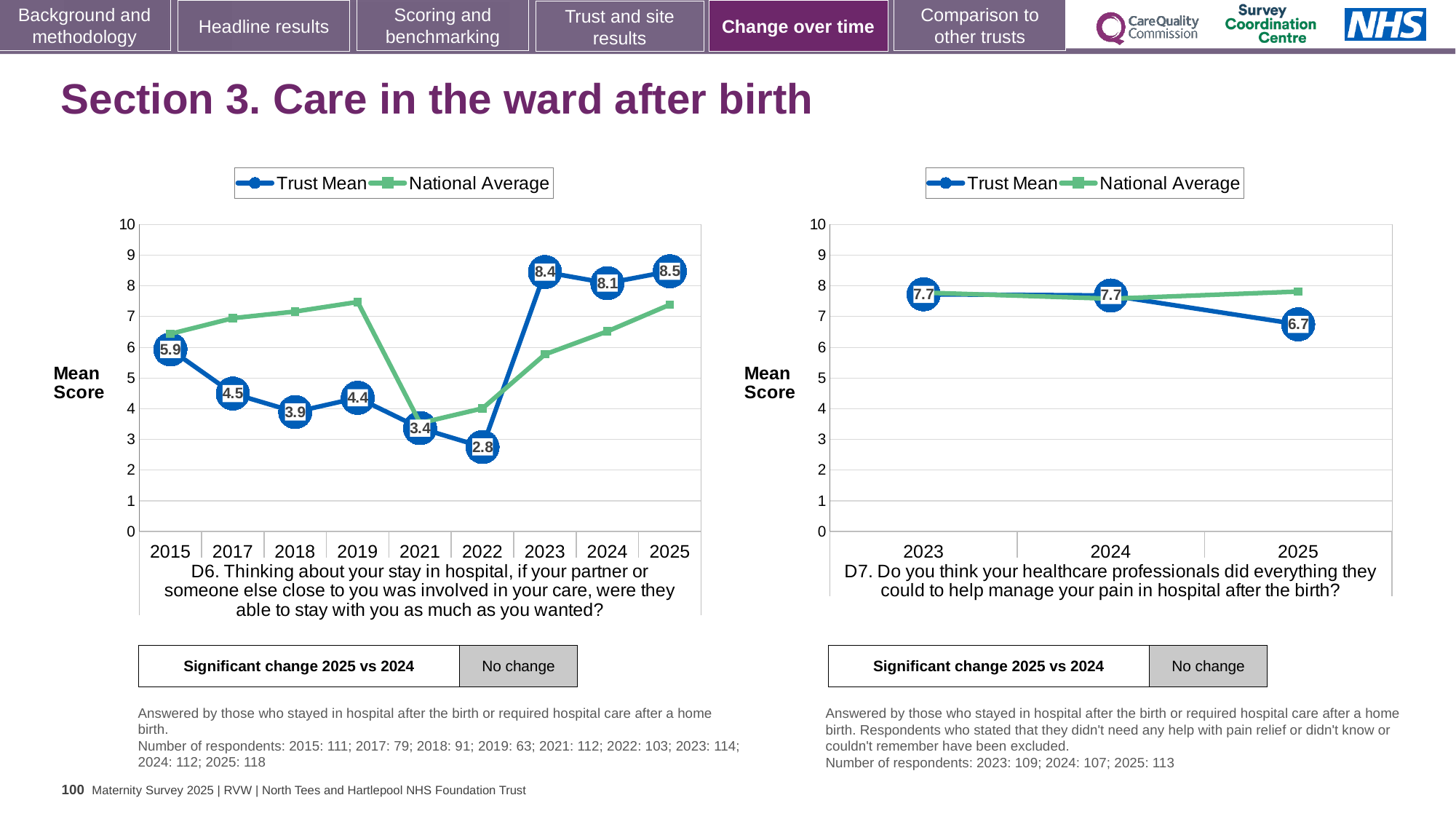
On the D6 chart (left), is the National Average for 2019 greater or less than 7? greater On the D6 chart (left), how many years are shown on the x axis? 9 On the D6 chart (left), what is the Trust Mean score for 2022? 2.8 On the D7 chart (right), what is the Trust Mean score for 2025? 6.7 On the D6 chart (left), which year has the lowest Trust Mean score? 2022 On the D6 chart (left), is the Trust Mean score for 2015 or 2019 larger? 2015 On the D6 chart (left), which year has the highest Trust Mean score? 2025 On the D6 chart (left), what is the difference between the Trust Mean scores for 2023 and 2022? 5.6 On the D7 chart (right), does the Trust Mean rise or fall from 2024 to 2025? fall How many series does the legend of the D7 chart (right) list? 2 On the D6 chart (left), what is the Trust Mean score for 2025? 8.5 On the D7 chart (right), what is the difference between the Trust Mean scores for 2024 and 2025? 1.0